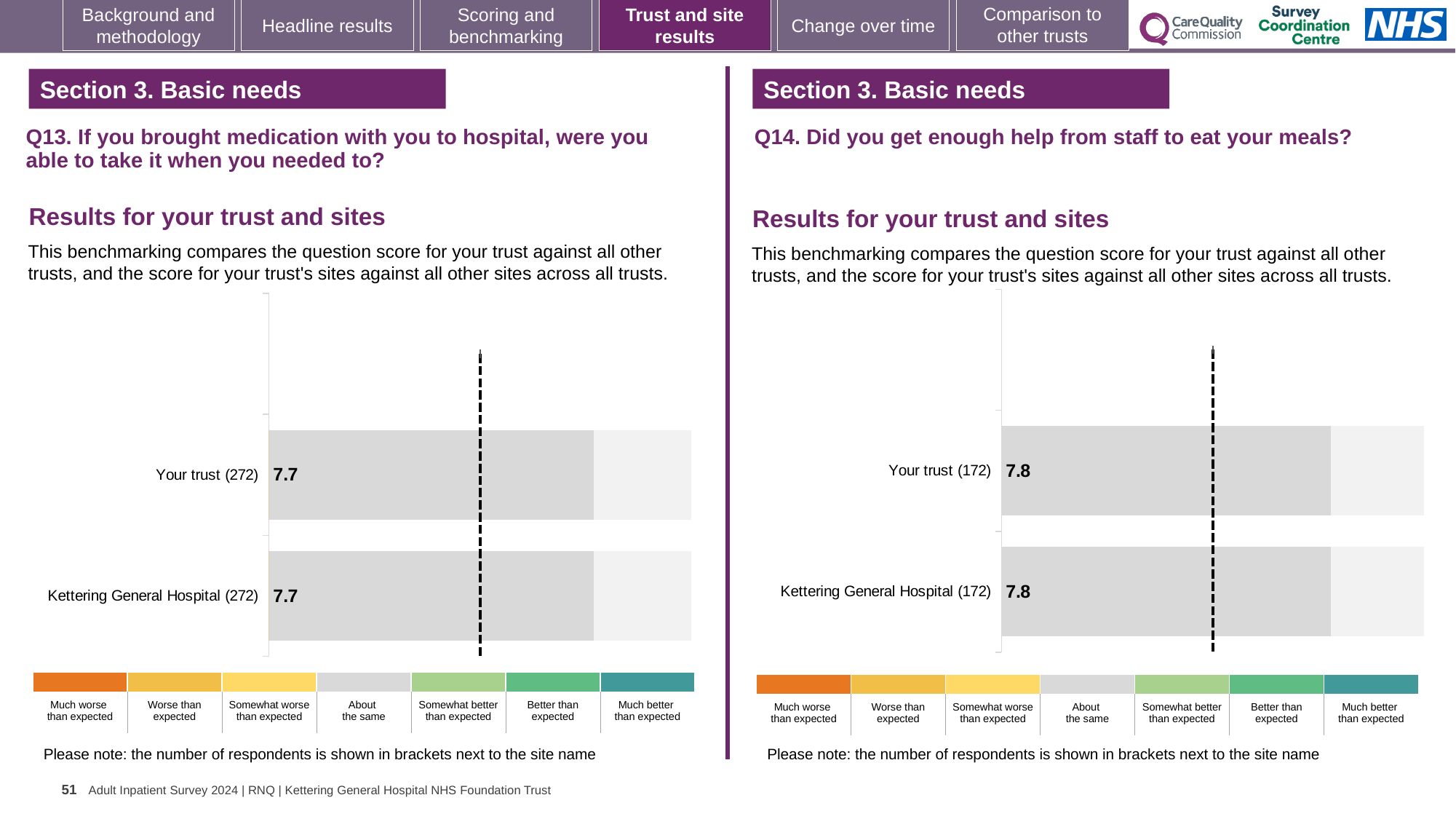
On the Q14 chart (right), what is the score for Kettering General Hospital? 7.8 On the Q13 chart (left), what is the score for Your trust? 7.7 On the Q13 chart (left), what is the difference between the Your trust score and the Kettering General Hospital score? 0 On the Q14 chart (right), which category does the colour key label for the grey band? About the same On the Q13 chart (left), how many respondents are shown in brackets for Your trust? 272 On the Q14 chart (right), what is the difference between the Your trust score and the Kettering General Hospital score? 0 What kind of chart is the Q13 chart on the left? Bar chart On the Q14 chart (right), how many bars are plotted? 2 On the Q14 chart (right), how many respondents are shown in brackets for Kettering General Hospital? 172 On the Q13 chart (left), how many bars are plotted? 2 On the Q13 chart (left), what is the score for Kettering General Hospital? 7.7 On the Q14 chart (right), what is the score for Your trust? 7.8